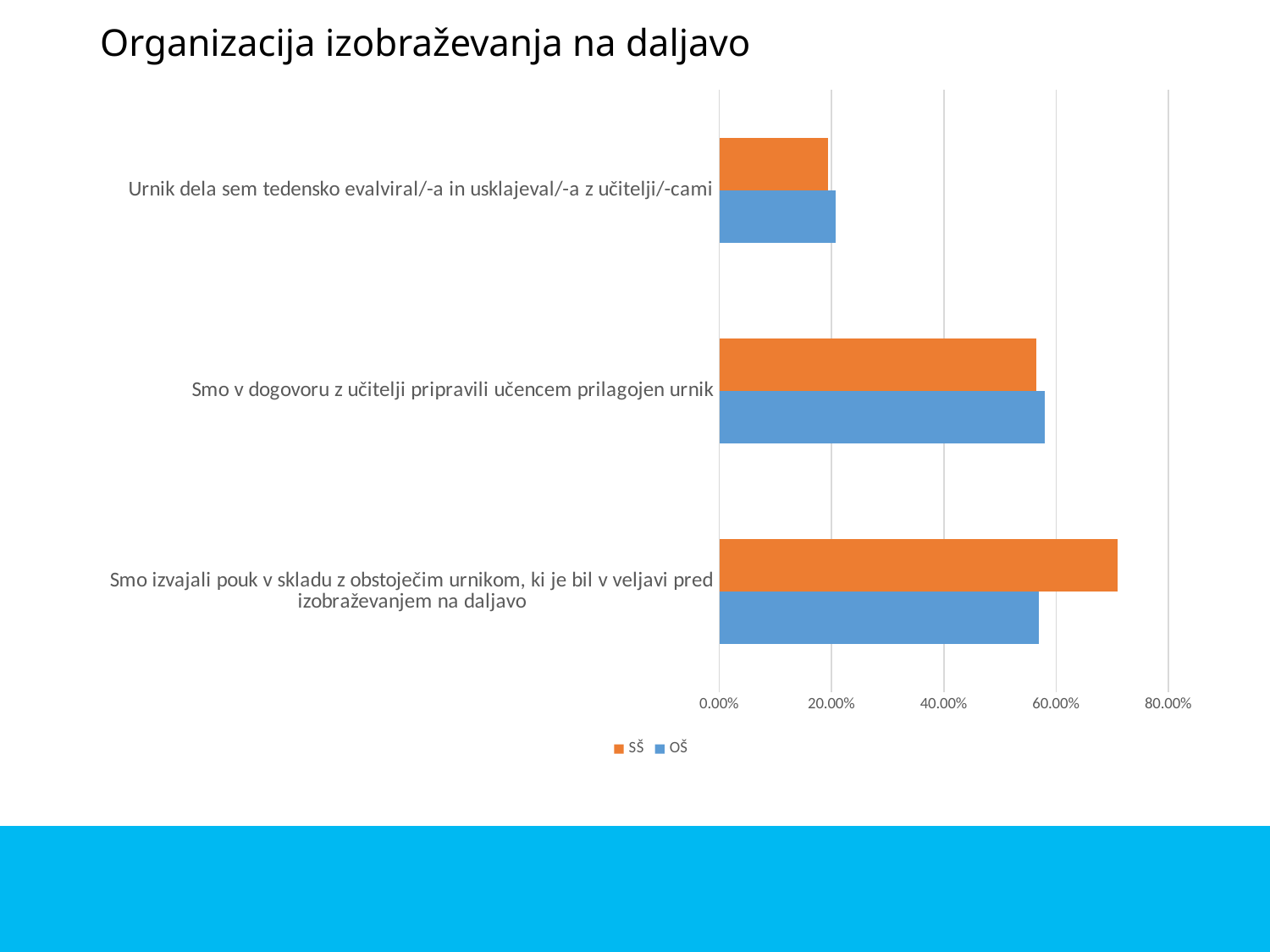
What kind of chart is shown on the slide? bar chart How many categories are shown on the chart? 3 For the category 'Smo izvajali pouk v skladu z obstoječim urnikom, ki je bil v veljavi pred izobraževanjem na daljavo', which series has the larger value, SŠ or OŠ? SŠ Is the SŠ value for 'Smo v dogovoru z učitelji pripravili učencem prilagojen urnik' greater or less than 40.00%? greater What is the title of the chart? Organizacija izobraževanja na daljavo Is the OŠ value for 'Smo izvajali pouk v skladu z obstoječim urnikom, ki je bil v veljavi pred izobraževanjem na daljavo' greater or less than 60.00%? less For the SŠ series, which category has the lowest value? Urnik dela sem tedensko evalviral/-a in usklajeval/-a z učitelji/-cami For the OŠ series, which category has the lowest value? Urnik dela sem tedensko evalviral/-a in usklajeval/-a z učitelji/-cami Is the SŠ value for 'Smo izvajali pouk v skladu z obstoječim urnikom, ki je bil v veljavi pred izobraževanjem na daljavo' greater or less than 60.00%? greater How many series does the legend list? 2 For the SŠ series, which category has the highest value? Smo izvajali pouk v skladu z obstoječim urnikom, ki je bil v veljavi pred izobraževanjem na daljavo Which series is shown in orange? SŠ